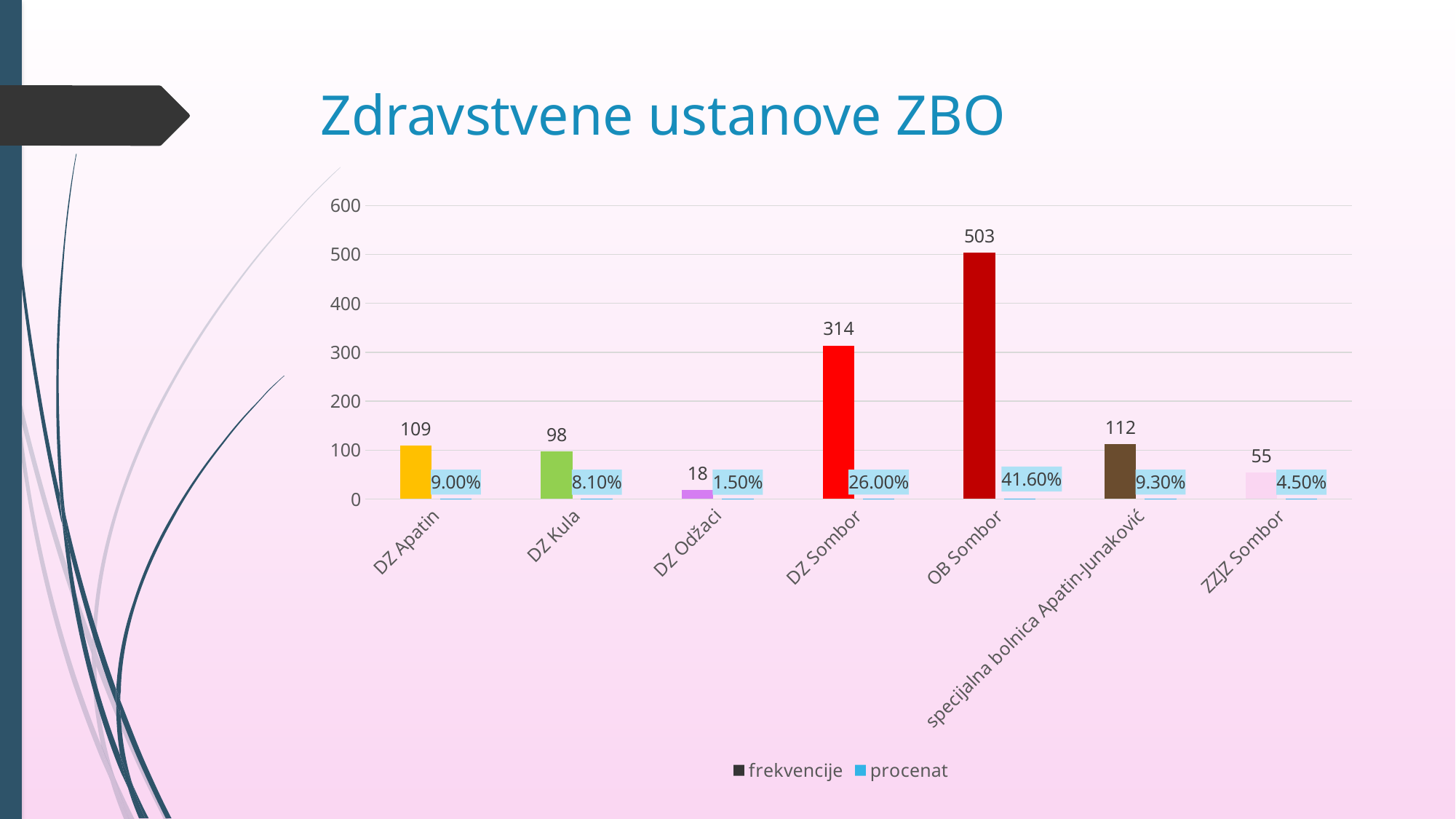
How many series does the legend list? 2 What is the frekvencije value for OB Sombor? 503 What is the procenat value for DZ Sombor? 26.00% How many categories are shown on the x axis? 7 What is the frekvencije value for specijalna bolnica Apatin-Junaković? 112 Which category has the highest frekvencije value? OB Sombor What kind of chart is shown on the slide? Bar chart Which category has the lowest frekvencije value? DZ Odžaci What is the title of the slide? Zdravstvene ustanove ZBO Which has a larger frekvencije value, DZ Apatin or DZ Kula? DZ Apatin What is the difference between the frekvencije values for OB Sombor and DZ Sombor? 189 What is the procenat value for ZZJZ Sombor? 4.50%